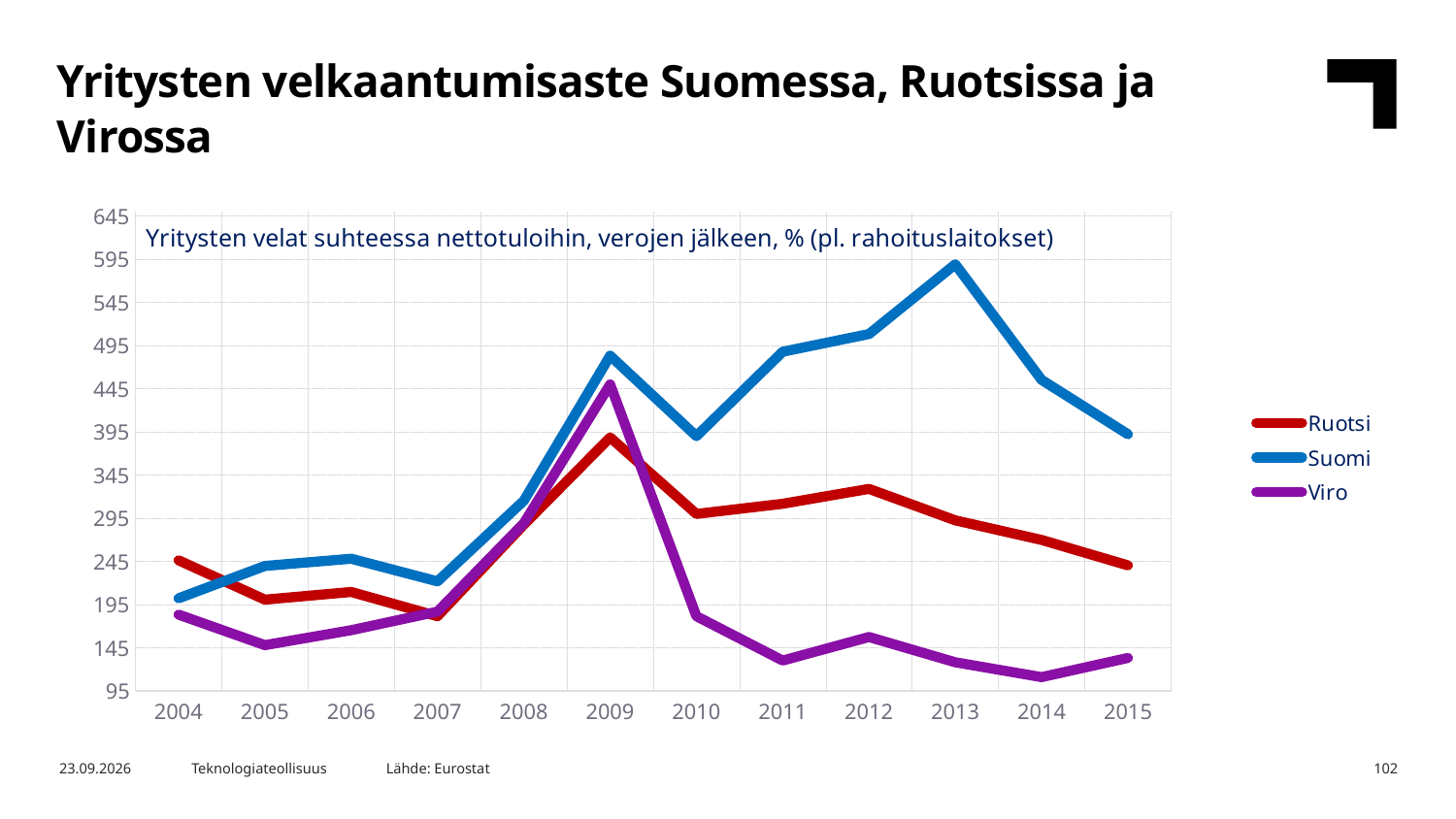
In which year does the Viro line reach its lowest value? 2014 Is the value for Suomi in 2013 greater or less than 545? greater Does the Suomi line rise or fall from 2013 to 2015? fall How many years are shown on the x axis? 12 Which series has the larger value in 2004, Ruotsi or Suomi? Ruotsi Is the value for Ruotsi in 2015 greater or less than 295? less In which year does the Ruotsi line reach its highest value? 2009 In which year does the Suomi line reach its highest value? 2013 Which series is drawn in purple? Viro Is the value for Viro in 2014 greater or less than 145? less How many series does the legend list? 3 What kind of chart is shown on the slide? line chart